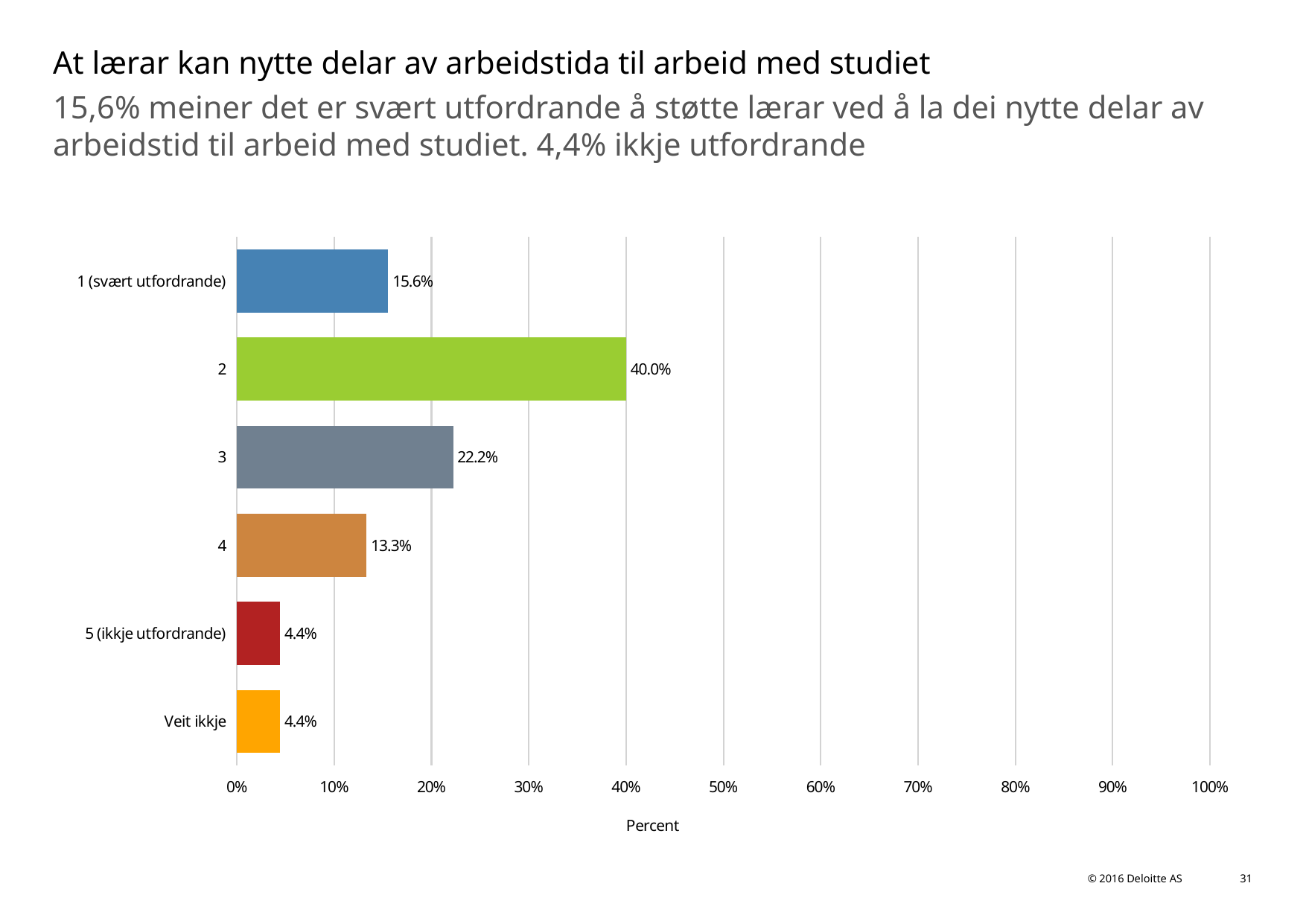
What is the difference between the values for '1 (svært utfordrande)' and '5 (ikkje utfordrande)'? 11.2% What is the value for category 2? 40.0% Which is larger, the value for category 3 or the value for category 4? 3 What is the value for category 4? 13.3% What is the label of the horizontal axis? Percent How many categories are shown on the chart? 6 What kind of chart is shown on the slide? bar chart Which category has the highest value? 2 What is the difference between the values for category 2 and category 3? 17.8% Is the value for category 3 greater or less than 20%? greater What is the value for 'Veit ikkje'? 4.4% What is the value for '1 (svært utfordrande)'? 15.6%